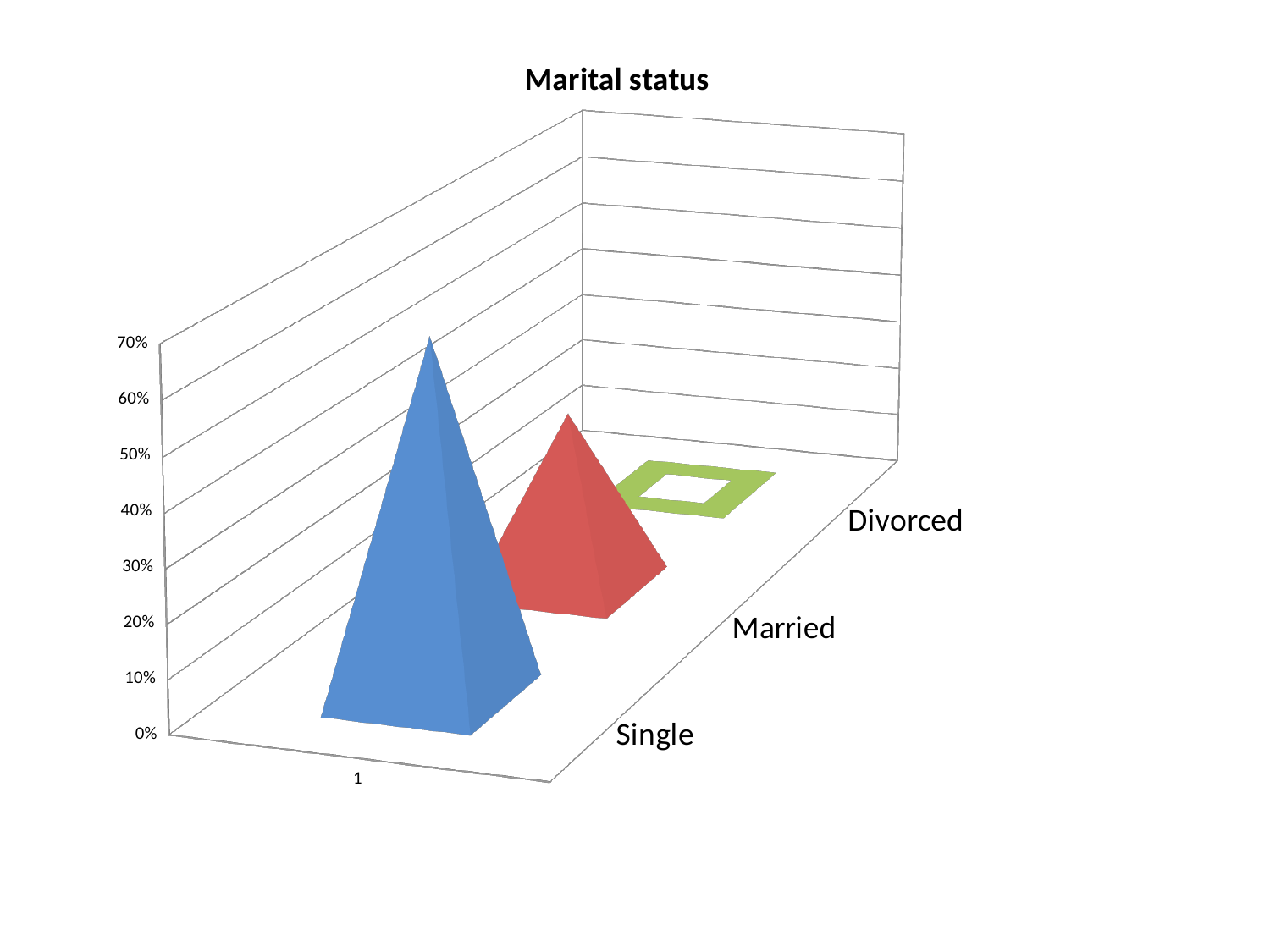
How many marital status categories are plotted in the chart? 3 Which marital status category has the highest value? Single Is the value for Divorced greater or less than 10%? less Which is larger, the value for Married or the value for Divorced? Married Is the value for Married greater or less than 10%? greater Which marital status category has the lowest value? Divorced Which is larger, the value for Single or the value for Married? Single Is the value for Single greater or less than 30%? greater What is the title of the chart? Marital status What kind of chart is shown on the slide? bar chart What is the highest value shown on the vertical axis? 70%